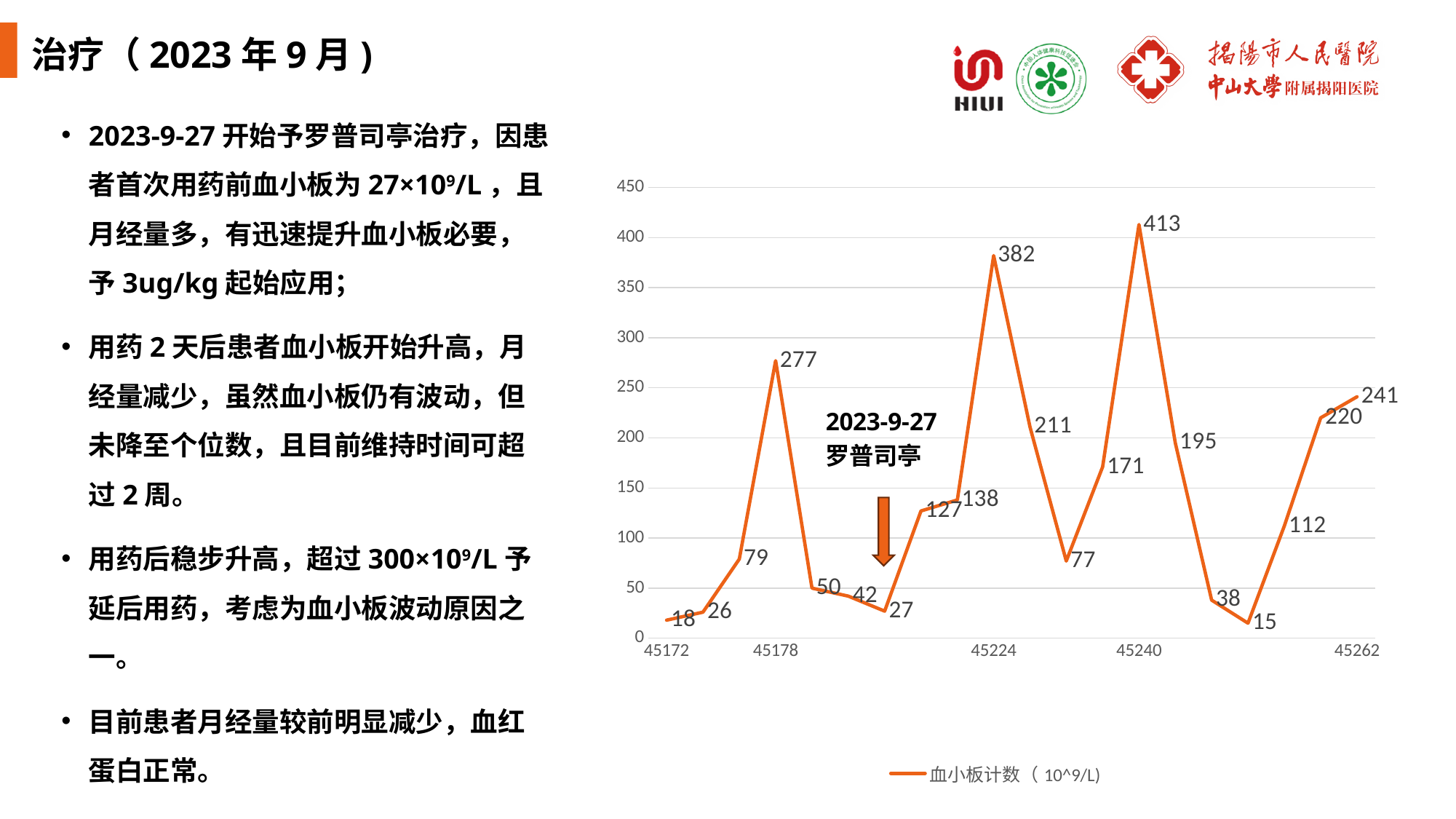
What is the highest platelet count value plotted on the chart? 413 What is the platelet count value at the x-axis label 45262? 241 What is the platelet count value at the x-axis label 45224? 382 What is the difference between the two highest peaks, 413 and 382? 31 What kind of chart is shown on the slide? line chart What is the platelet count value at the x-axis label 45240? 413 What is the legend entry for the plotted line? 血小板计数（10^9/L） Which is larger, the peak labelled 277 or the final point labelled 241? 277 What is the lowest platelet count value plotted on the chart? 15 How many data points are plotted on the line? 20 What is the platelet count value at the x-axis label 45172? 18 How many series does the legend list? 1